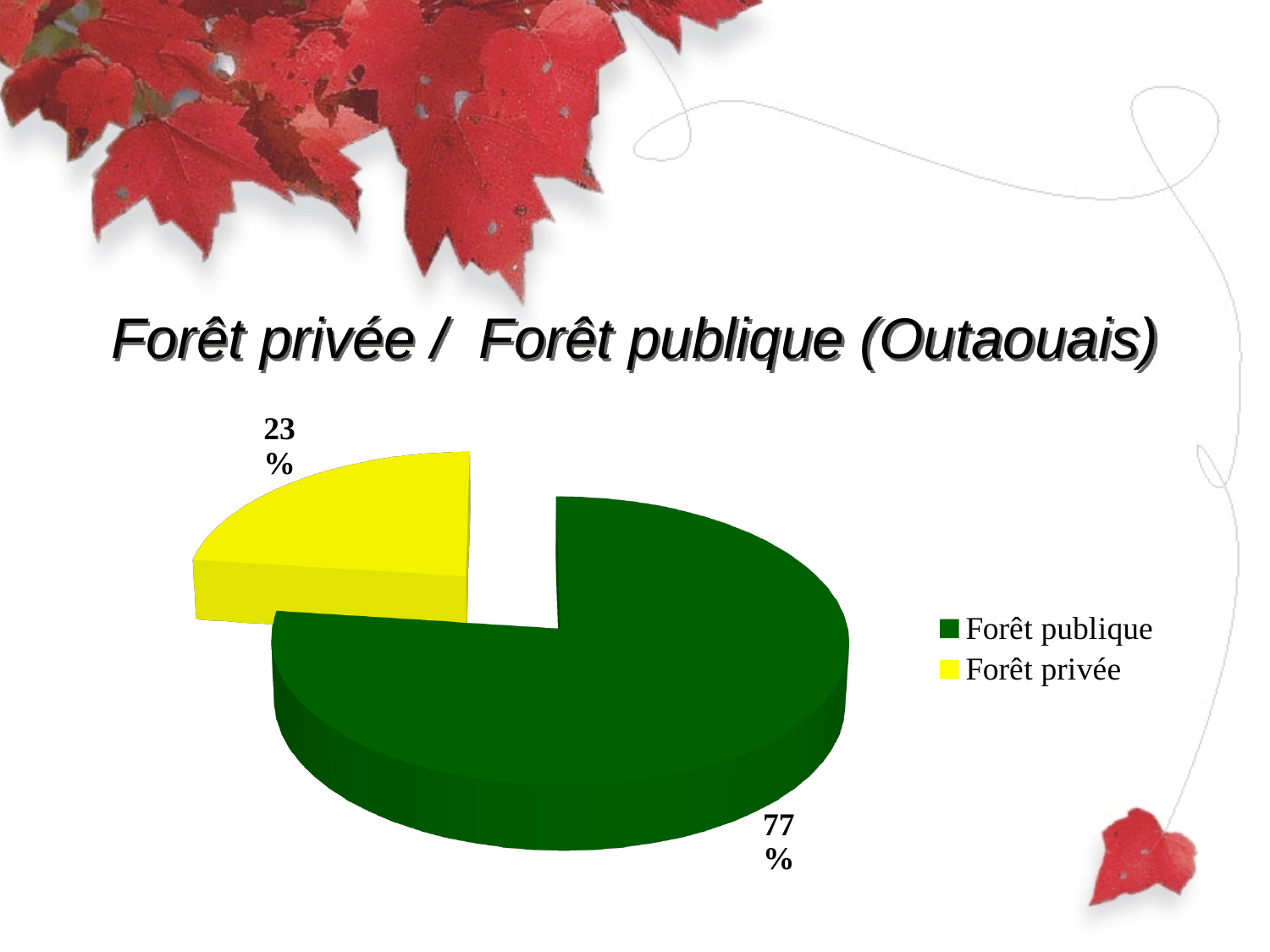
Which category has the smallest slice of the pie? Forêt privée How many slices does the pie chart have? 2 What share of the pie does Forêt privée represent? 23% What kind of chart is shown on the slide? pie chart How many entries does the legend list? 2 What is the title of the slide containing the chart? Forêt privée / Forêt publique (Outaouais) Which is larger, the share for Forêt publique or the share for Forêt privée? Forêt publique What is the difference in percentage points between Forêt publique and Forêt privée? 54 Which category has the largest slice of the pie? Forêt publique What colour is the slice for Forêt privée? yellow What share of the pie does Forêt publique represent? 77%